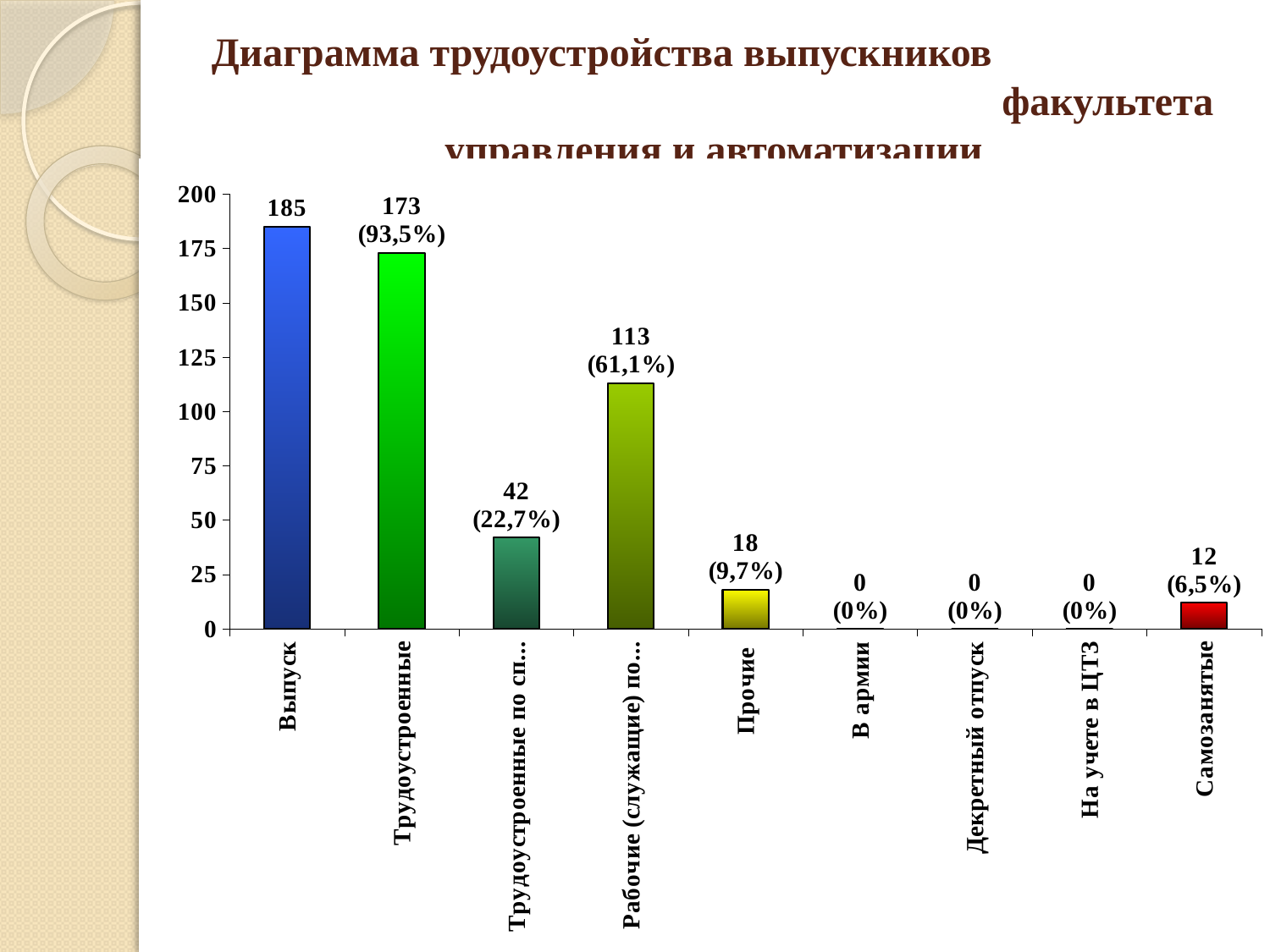
What is the value for Трудоустроенные? 173 What is the value for Самозанятые? 12 What is the difference between the values for Выпуск and Трудоустроенные? 12 What is the value for Выпуск? 185 What percentage is shown for Самозанятые? 6,5% Which category has the highest value? Выпуск What is the value for Прочие? 18 How many categories have a value of 0? 3 Which is larger, the value for Прочие or the value for Самозанятые? Прочие What kind of chart is shown on the slide? Bar chart What percentage is shown for Трудоустроенные? 93,5% How many categories are shown on the x axis? 9